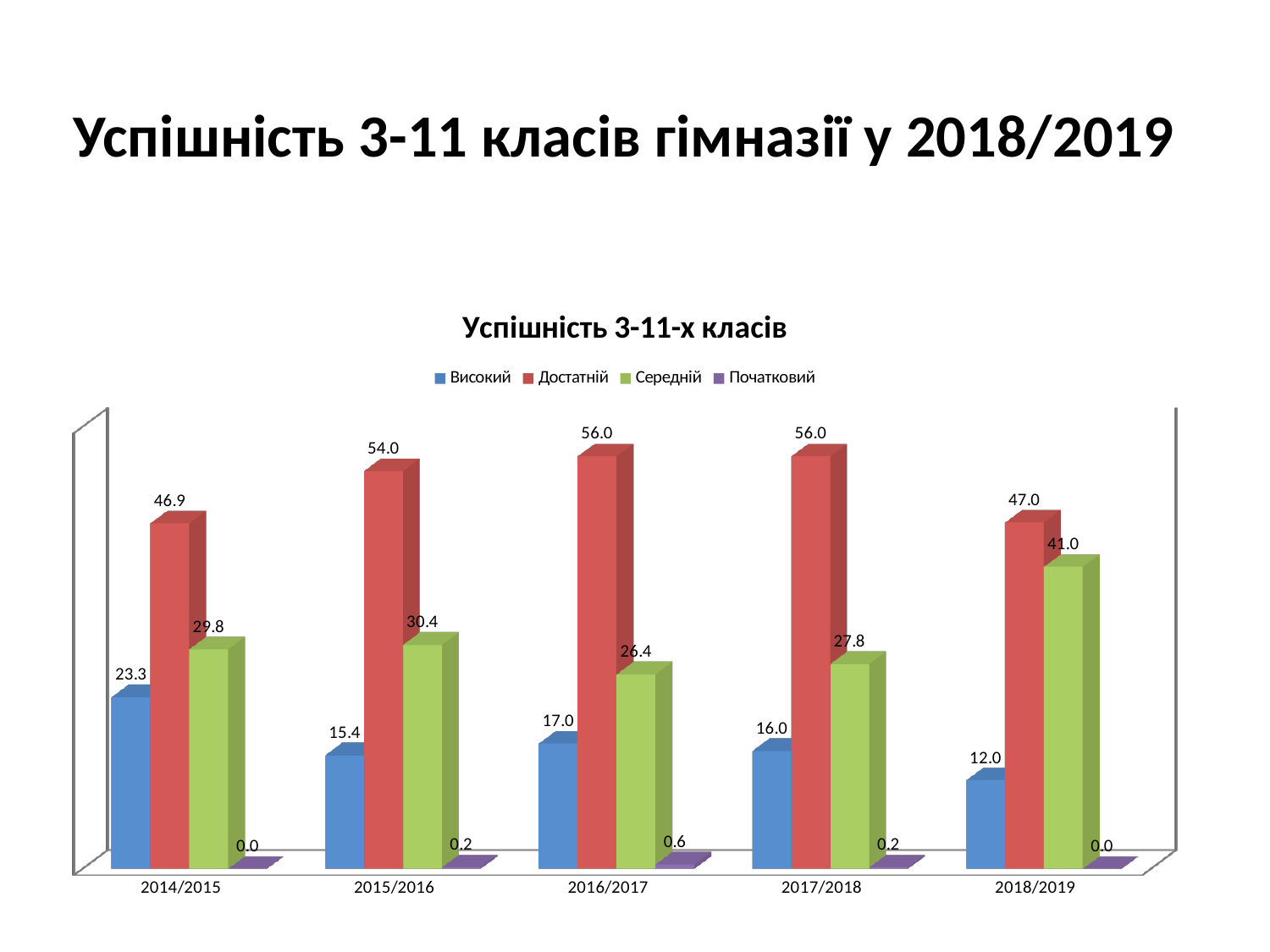
What kind of chart is this? bar chart What is the difference between Достатній and Середній in 2018/2019? 6.0 In which year is the value for Середній lowest? 2016/2017 How many series does the legend list? 4 What is the value for Високий in 2018/2019? 12.0 What is the value for Середній in 2016/2017? 26.4 What is the value for Початковий in 2016/2017? 0.6 What is the value for Достатній in 2015/2016? 54.0 How many years are shown on the x axis? 5 Which is larger in 2014/2015: Високий or Середній? Середній What is the title of the chart? Успішність 3-11-х класів In which year is the value for Високий highest? 2014/2015